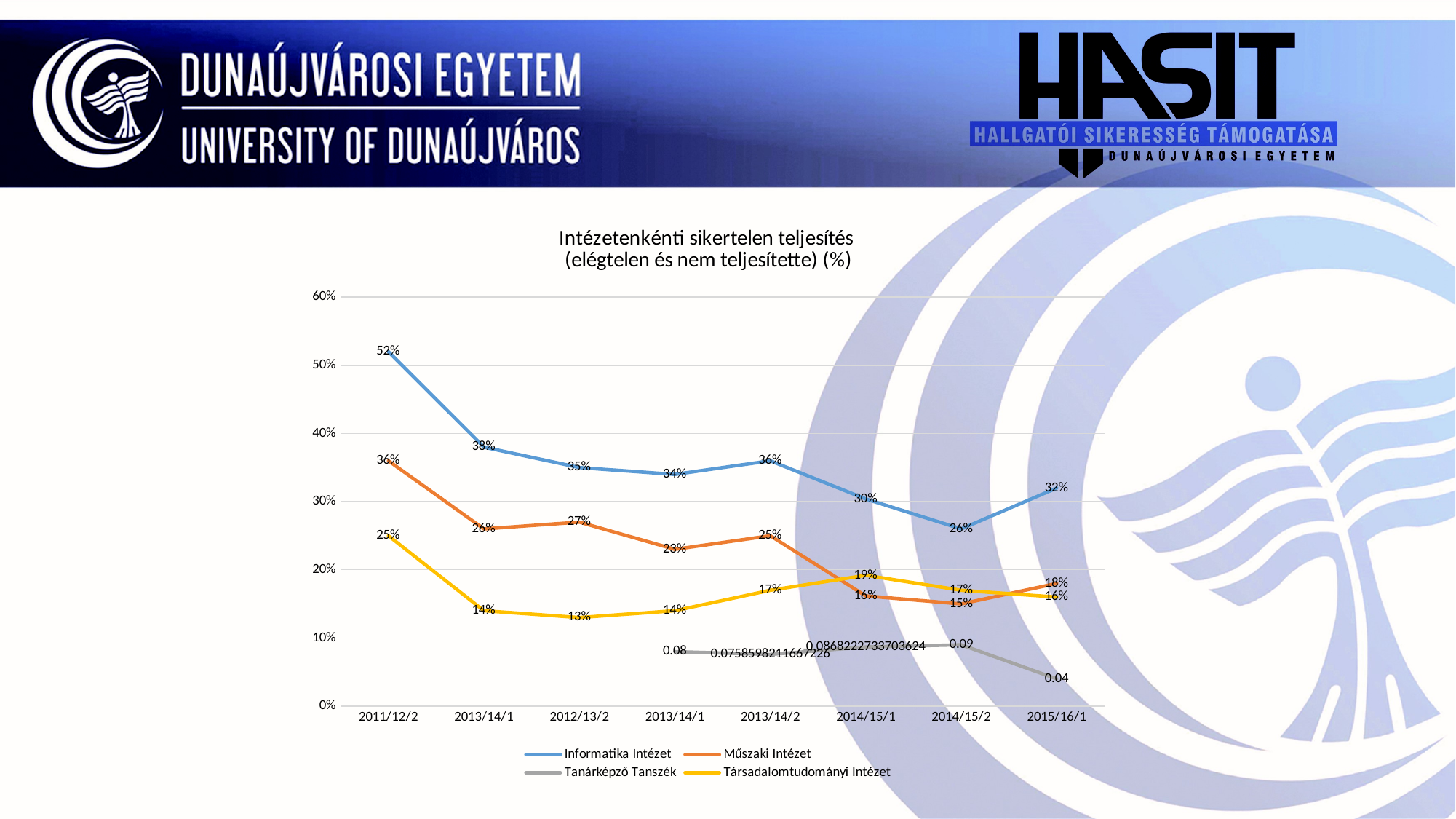
What is the value for Társadalomtudományi Intézet in 2012/13/2? 13% What is the value for Informatika Intézet in 2011/12/2? 52% What kind of chart is shown on the slide? line chart How many categories are shown on the x axis? 8 What is the title of the chart? Intézetenkénti sikertelen teljesítés (elégtelen és nem teljesítette) (%) What is the difference between Informatika Intézet and Műszaki Intézet in 2011/12/2? 16 percentage points How many series does the legend list? 4 In which period is the Műszaki Intézet value highest? 2011/12/2 In which period is the Informatika Intézet value lowest? 2014/15/2 What is the value for Műszaki Intézet in 2015/16/1? 18% What is the value for Tanárképző Tanszék in 2015/16/1? 0.04 In 2014/15/1, which is larger: Társadalomtudományi Intézet or Műszaki Intézet? Társadalomtudományi Intézet